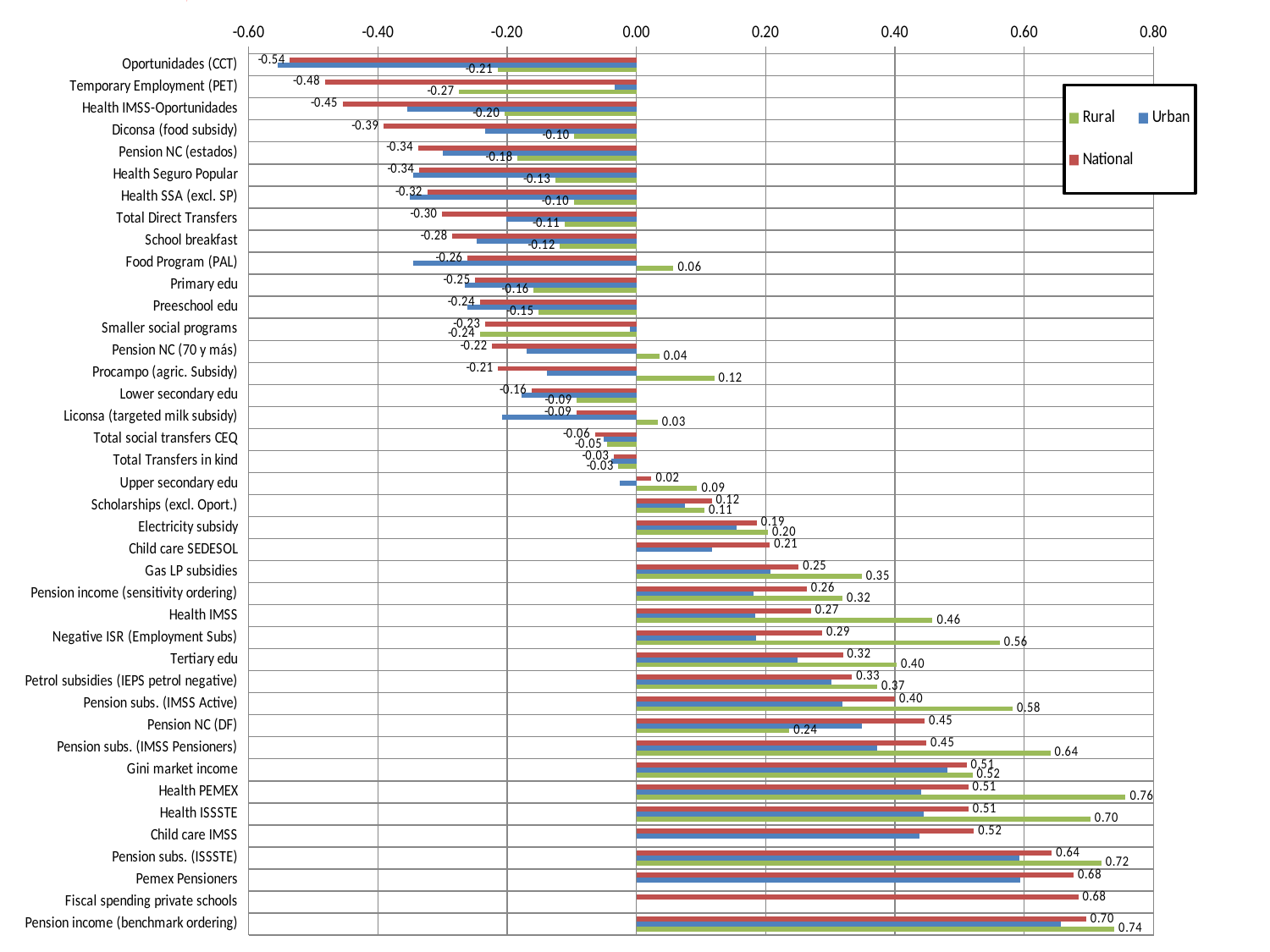
Which category has the lowest National value? Oportunidades (CCT) Which series is shown in green in the legend? Rural What is the Rural value for Negative ISR (Employment Subs)? 0.56 What is the difference between the Rural and National values for Health PEMEX? 0.25 Is the Urban value for Pemex Pensioners greater or less than 0.40? greater What is the National value for Oportunidades (CCT)? -0.54 Which category has the highest Rural value? Health PEMEX What kind of chart is shown on the slide? bar chart Which has the larger Rural value, Health IMSS or Tertiary edu? Health IMSS What is the National value for Procampo (agric. Subsidy)? -0.21 How many series does the legend list? 3